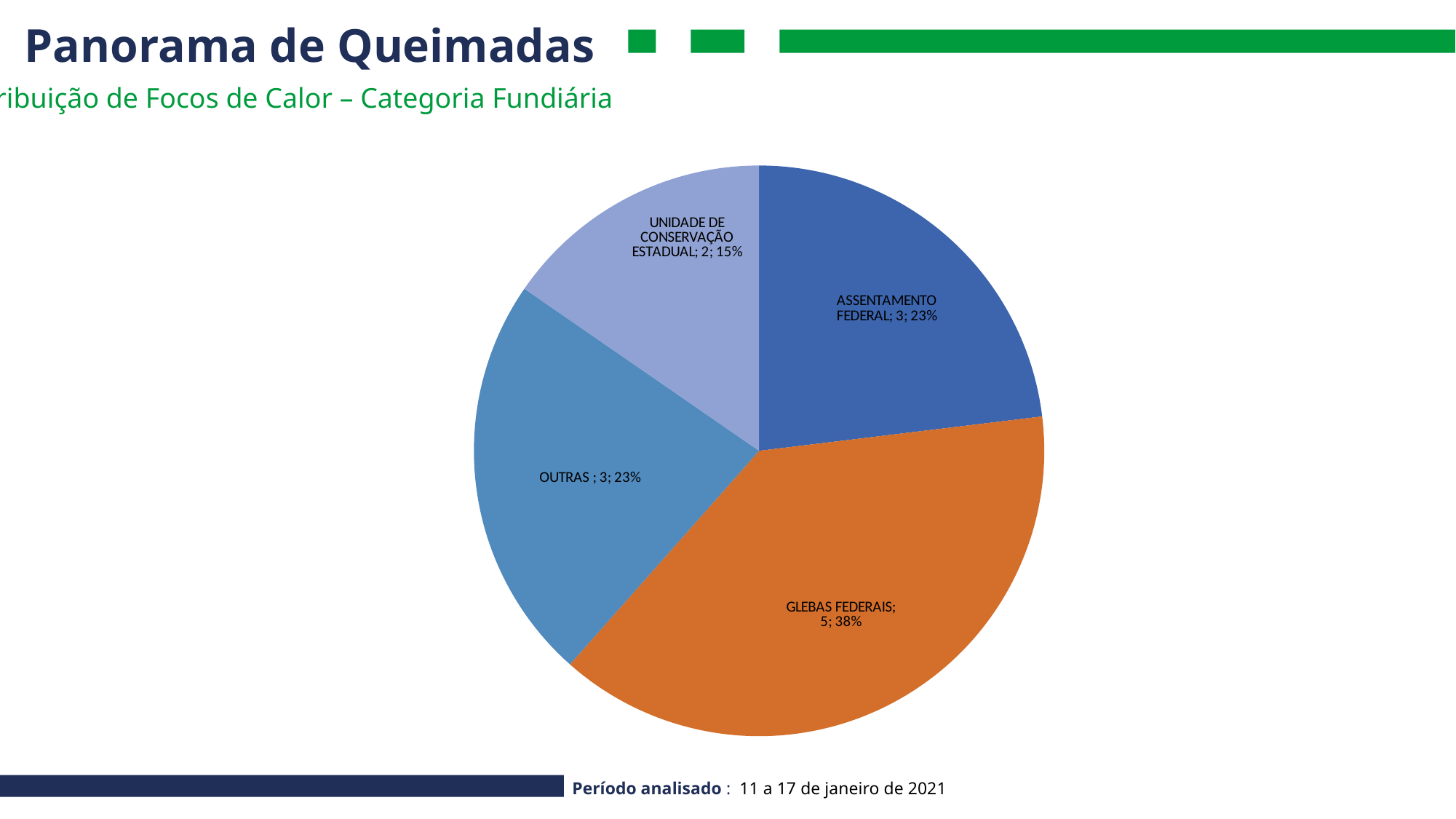
What share of the pie does GLEBAS FEDERAIS represent? 38% Which category has the smallest slice of the pie? UNIDADE DE CONSERVAÇÃO ESTADUAL How many slices does the pie chart have? 4 What share of the pie does UNIDADE DE CONSERVAÇÃO ESTADUAL represent? 15% Which category has the largest slice of the pie? GLEBAS FEDERAIS What kind of chart is shown on the slide? pie chart What is the value for UNIDADE DE CONSERVAÇÃO ESTADUAL? 2 What is the difference between the values for GLEBAS FEDERAIS and UNIDADE DE CONSERVAÇÃO ESTADUAL? 3 Which is larger, the value for GLEBAS FEDERAIS or the value for ASSENTAMENTO FEDERAL? GLEBAS FEDERAIS What is the value for GLEBAS FEDERAIS? 5 What is the value for OUTRAS? 3 What share of the pie does ASSENTAMENTO FEDERAL represent? 23%